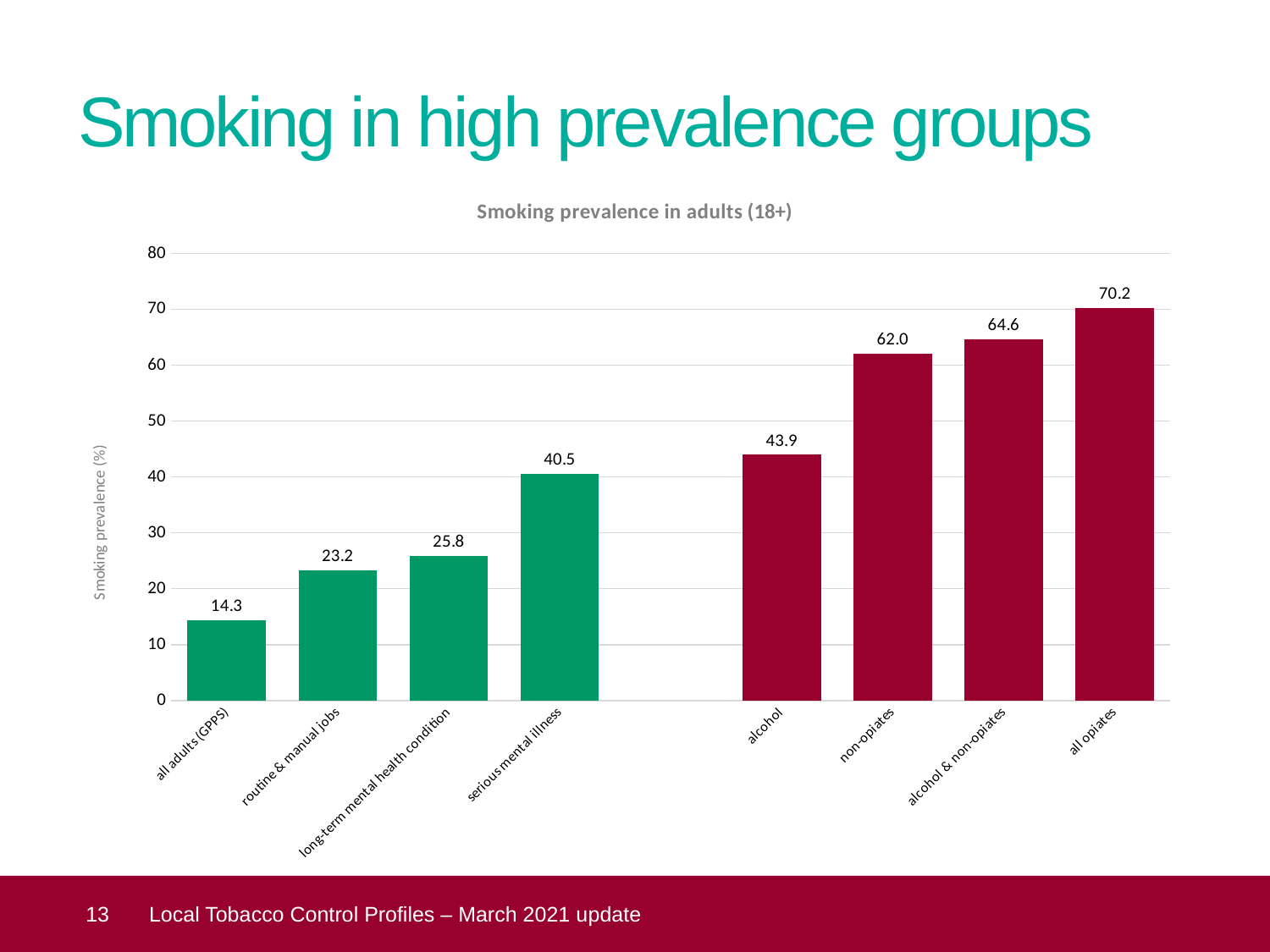
Which group has the lowest smoking prevalence? all adults (GPPS) What type of chart is shown on the slide? bar chart Which has a higher smoking prevalence, alcohol or serious mental illness? alcohol What is the title of the chart? Smoking prevalence in adults (18+) What is the difference in smoking prevalence between all opiates and all adults (GPPS)? 55.9 What is the smoking prevalence for all adults (GPPS)? 14.3 Which group has the highest smoking prevalence? all opiates How many groups are shown in the chart? 8 What is the difference in smoking prevalence between routine & manual jobs and long-term mental health condition? 2.6 What is the smoking prevalence for the alcohol & non-opiates group? 64.6 What is the smoking prevalence for people with serious mental illness? 40.5 Is the smoking prevalence for non-opiates greater or less than 60? greater